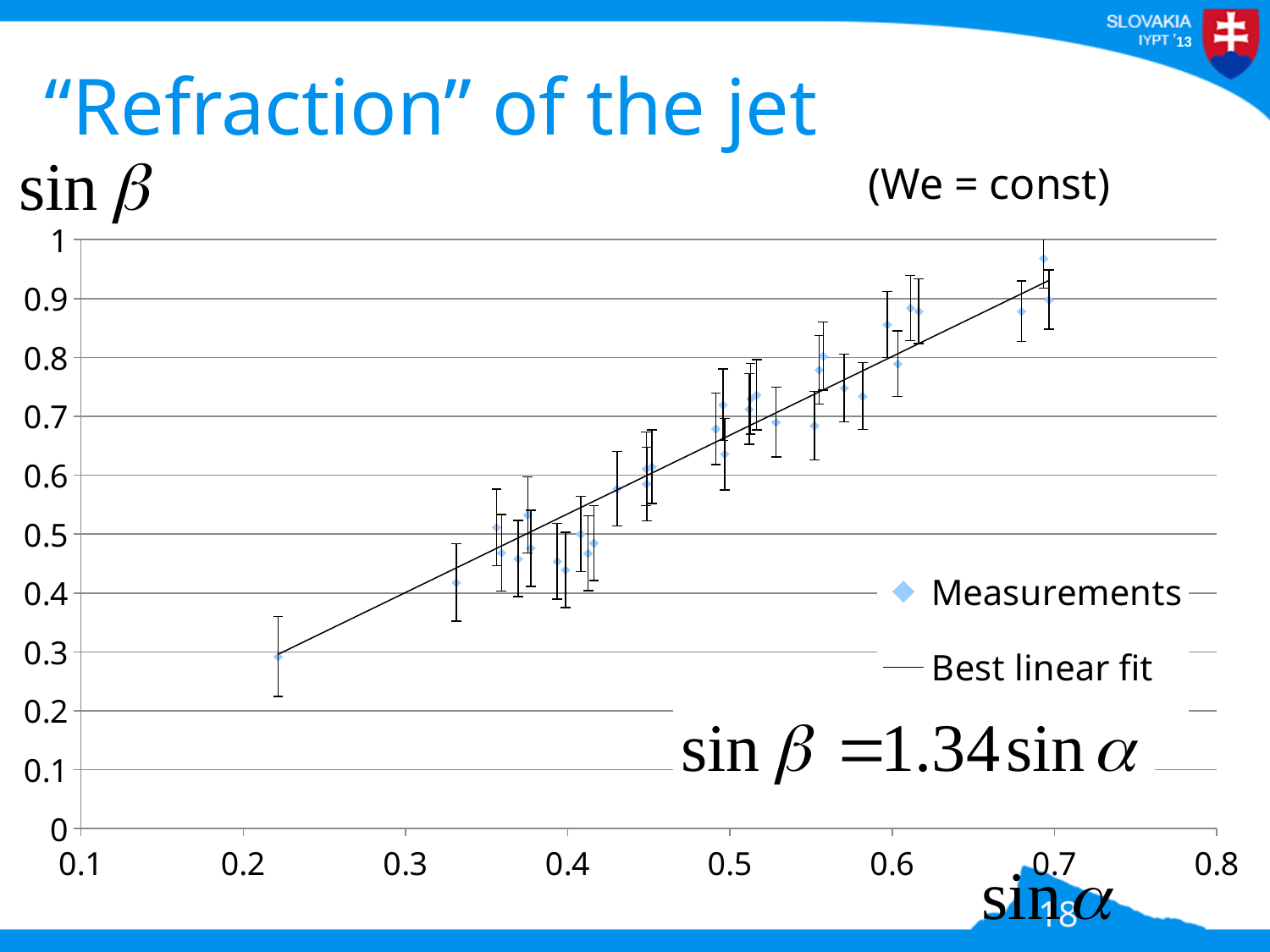
Which has the larger sin β value: the leftmost measurement point (near sin α = 0.22) or the measurement point near sin α = 0.33? the point near sin α = 0.33 What is the slope of the best linear fit given in the equation on the chart? 1.34 What is the maximum value shown on the x axis (sin α)? 0.8 Is the sin β value of the highest measurement point (near sin α = 0.7) greater or less than 0.9? greater What are the two entries in the chart legend? Measurements; Best linear fit Do the measured values of sin β rise or fall as sin α increases along the x axis? rise What is the title of the slide containing the chart? "Refraction" of the jet What equation is printed on the chart for the best linear fit? sin β = 1.34 sin α What kind of chart is shown on the slide? scatter chart What is the maximum value shown on the y axis (sin β)? 1 How many series does the chart legend list? 2 Is the sin β value of the leftmost measurement point (near sin α = 0.22) greater or less than 0.4? less